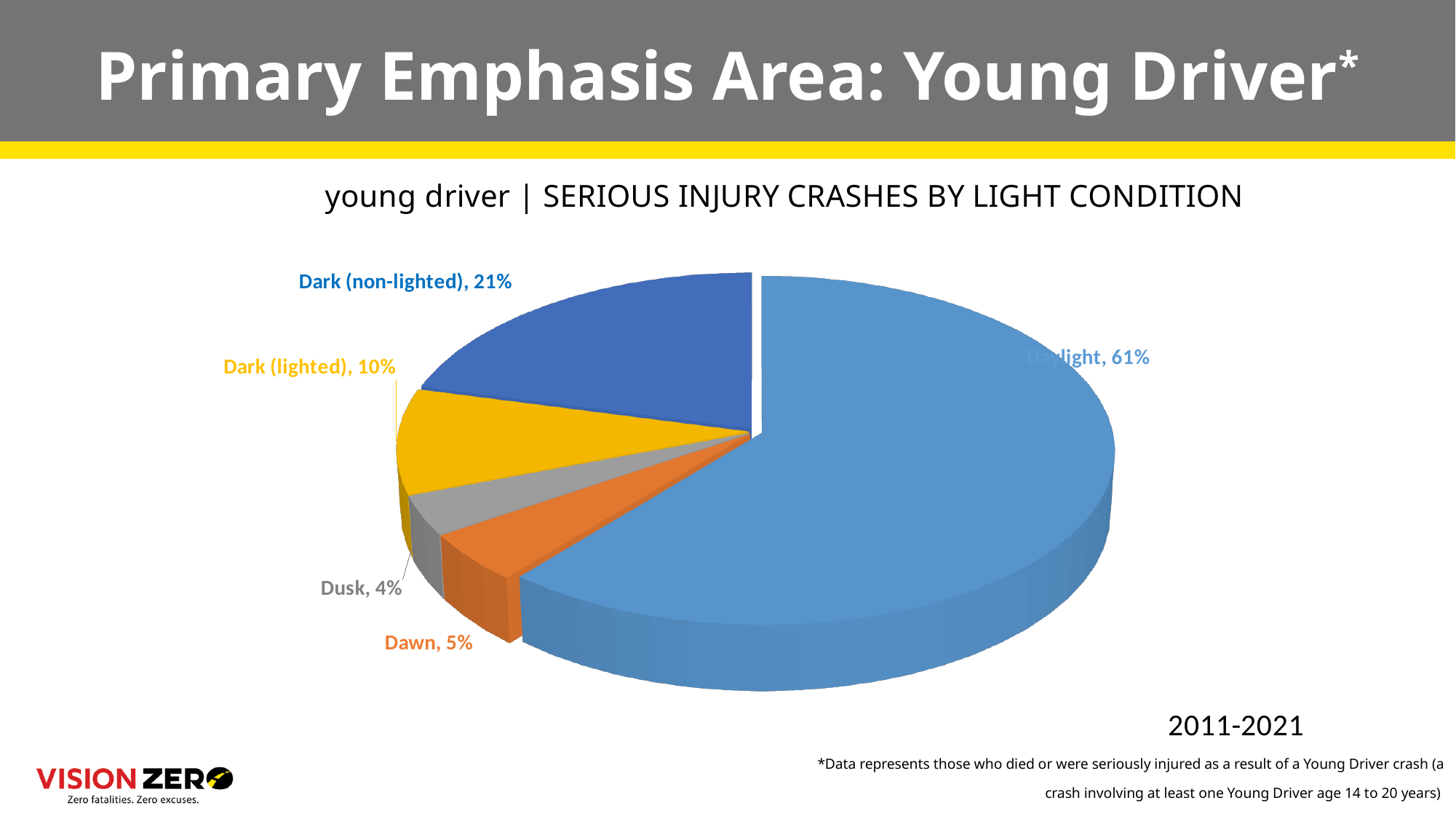
What percentage of serious injury crashes occurred in Dark (non-lighted) conditions? 21% What time period does the chart cover? 2011-2021 Which has a larger share of serious injury crashes, Dawn or Dusk? Dawn What type of chart is used to show serious injury crashes by light condition? Pie chart Which light condition accounts for the largest share of young driver serious injury crashes? Daylight What is the combined share of the two Dark categories (lighted and non-lighted)? 31% How many light condition categories are shown in the pie chart? 5 How many percentage points higher is the Dark (non-lighted) share than the Dark (lighted) share? 11 What percentage of serious injury crashes occurred in Dark (lighted) conditions? 10% Which light condition accounts for the smallest share of young driver serious injury crashes? Dusk What share of young driver serious injury crashes occurred in Daylight? 61% What percentage of serious injury crashes occurred at Dawn? 5%